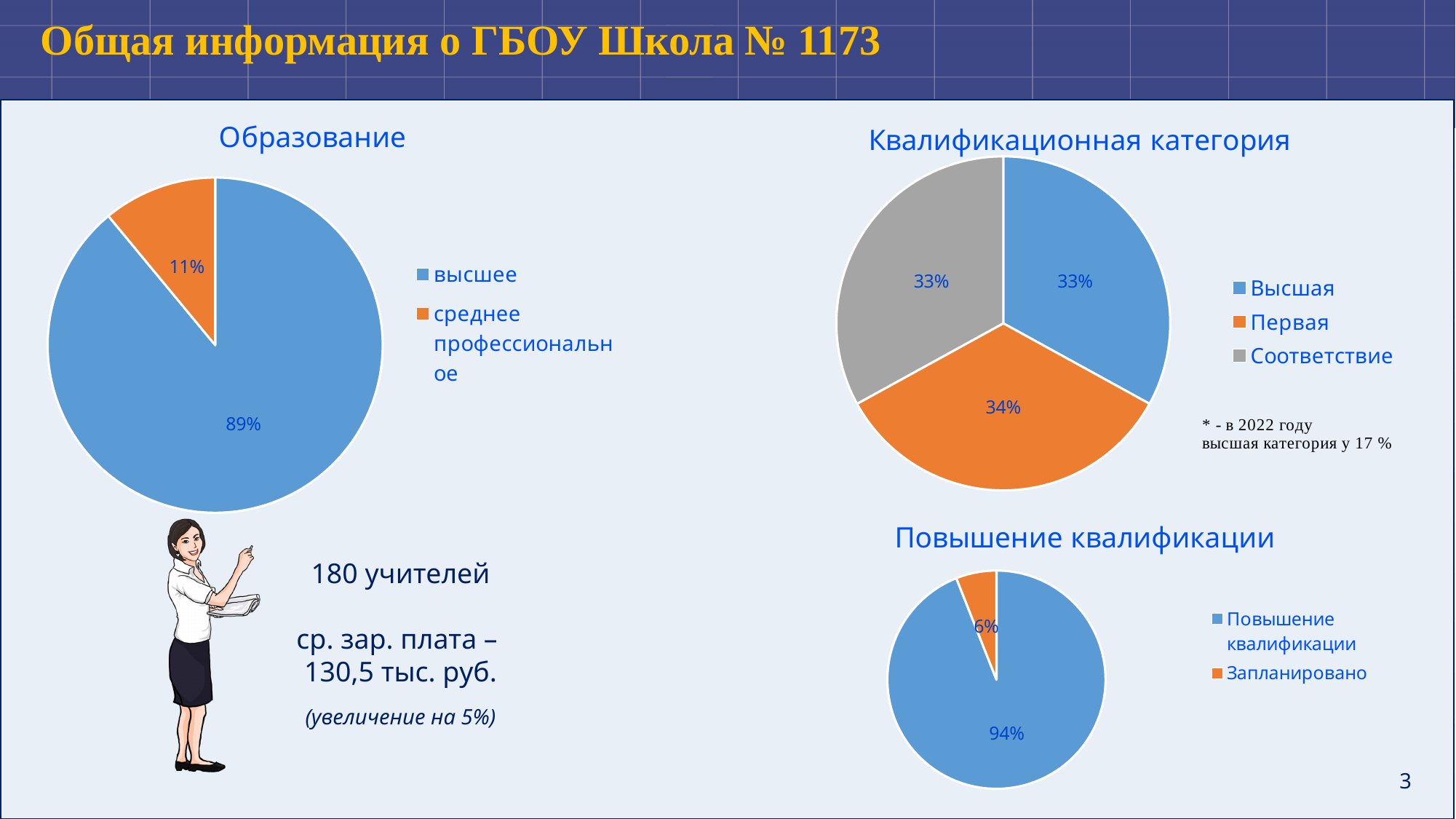
In the 'Квалификационная категория' chart, what share is labelled for 'Первая'? 34% In the 'Образование' chart, what share is labelled for 'высшее'? 89% In the 'Образование' chart, what share is labelled for 'среднее профессиональное'? 11% In the 'Образование' chart, what is the difference in percentage points between 'высшее' and 'среднее профессиональное'? 78 In the 'Квалификационная категория' chart, what colour is the 'Соответствие' slice? grey In the 'Квалификационная категория' chart, what share is labelled for 'Соответствие'? 33% How many categories does the 'Квалификационная категория' chart show? 3 In the 'Повышение квалификации' chart, which is larger: 'Повышение квалификации' or 'Запланировано'? Повышение квалификации In the 'Повышение квалификации' chart, which category has the smallest slice? Запланировано In the 'Образование' chart, which category has the largest slice? высшее In the 'Повышение квалификации' chart, what share is labelled for 'Запланировано'? 6% What type of chart is 'Квалификационная категория'? pie chart